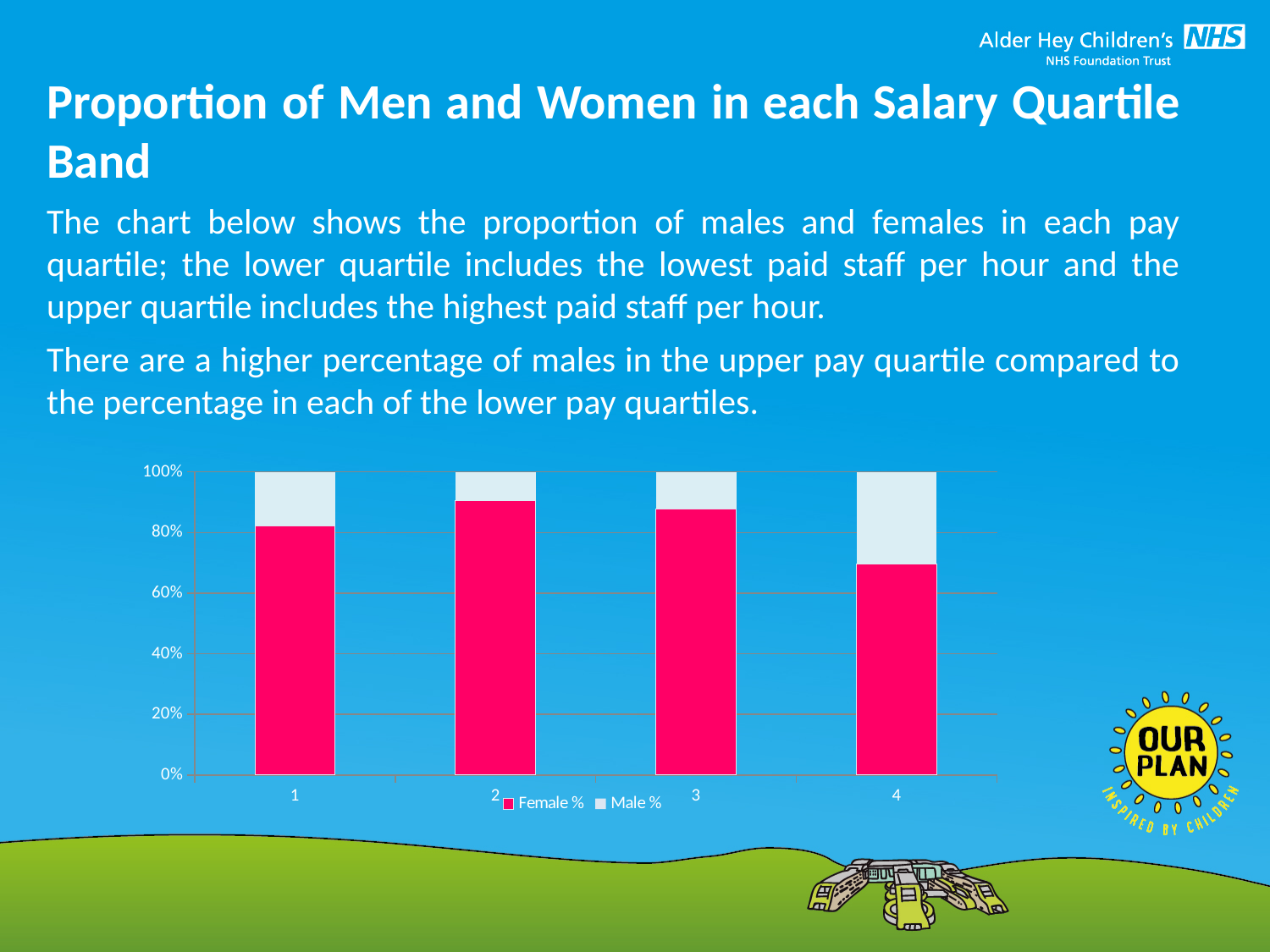
What is the total height of the stacked bar for quartile 4? 100% Is the Female % value for quartile 2 greater or less than 80%? greater Is the Male % value for quartile 4 greater or less than 20%? greater Which quartile has the highest Male % value? 4 Is the Female % value for quartile 4 greater or less than 60%? greater Which is larger, the Female % value for quartile 1 or for quartile 4? quartile 1 What kind of chart is shown on the slide? stacked bar chart How many salary quartile categories are shown on the x axis? 4 Which quartile has the lowest Female % value? 4 How many series does the legend list? 2 Which series is shown in pink in the chart? Female %